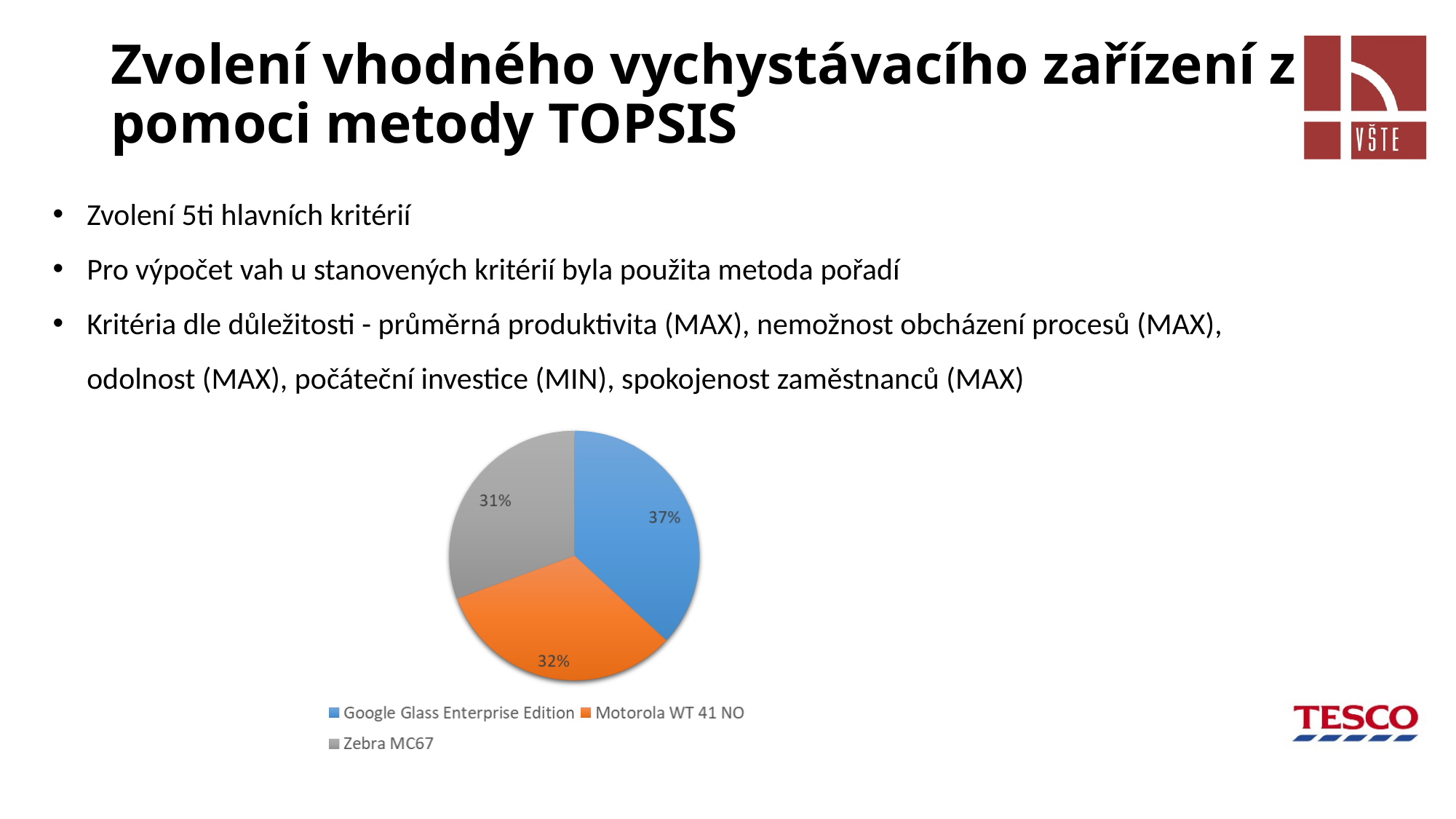
How many slices does the pie chart have? 3 How many entries does the legend list? 3 What kind of chart is shown on the slide? pie chart What is the difference in percentage points between the Google Glass Enterprise Edition slice and the Zebra MC67 slice? 6 What colour is the Motorola WT 41 NO slice in the pie chart? orange What share of the pie does Zebra MC67 have? 31% What is the difference in percentage points between the Motorola WT 41 NO slice and the Zebra MC67 slice? 1 What share of the pie does Google Glass Enterprise Edition have? 37% What share of the pie does Motorola WT 41 NO have? 32% Which device has the largest slice of the pie? Google Glass Enterprise Edition Which device has the smallest slice of the pie? Zebra MC67 Which slice is larger, Google Glass Enterprise Edition or Motorola WT 41 NO? Google Glass Enterprise Edition